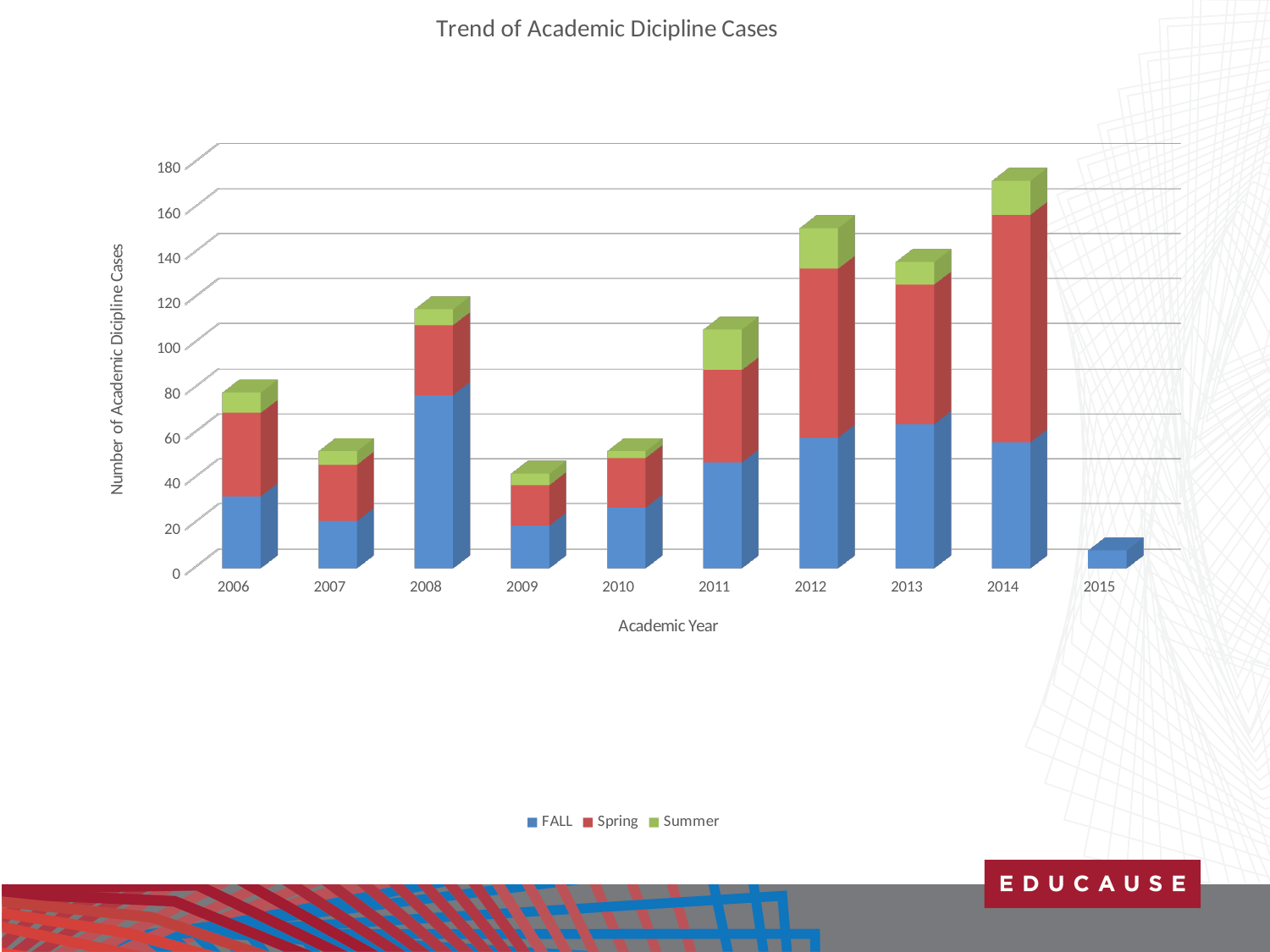
What is the title of the chart? Trend of Academic Dicipline Cases What is the label of the x axis? Academic Year Is the FALL value for 2008 greater or less than 60? greater Is the total number of cases for 2009 greater or less than 60? less Is the total number of cases for 2014 greater or less than 160? greater How many series does the legend list? 3 Which year has a larger total number of cases, 2012 or 2013? 2012 What kind of chart is shown on the slide? Stacked bar chart Which academic year has the lowest total number of academic discipline cases? 2015 Do the total number of cases rise or fall from 2009 to 2012? rise How many academic years are shown on the x axis? 10 Which academic year has the highest total number of academic discipline cases? 2014